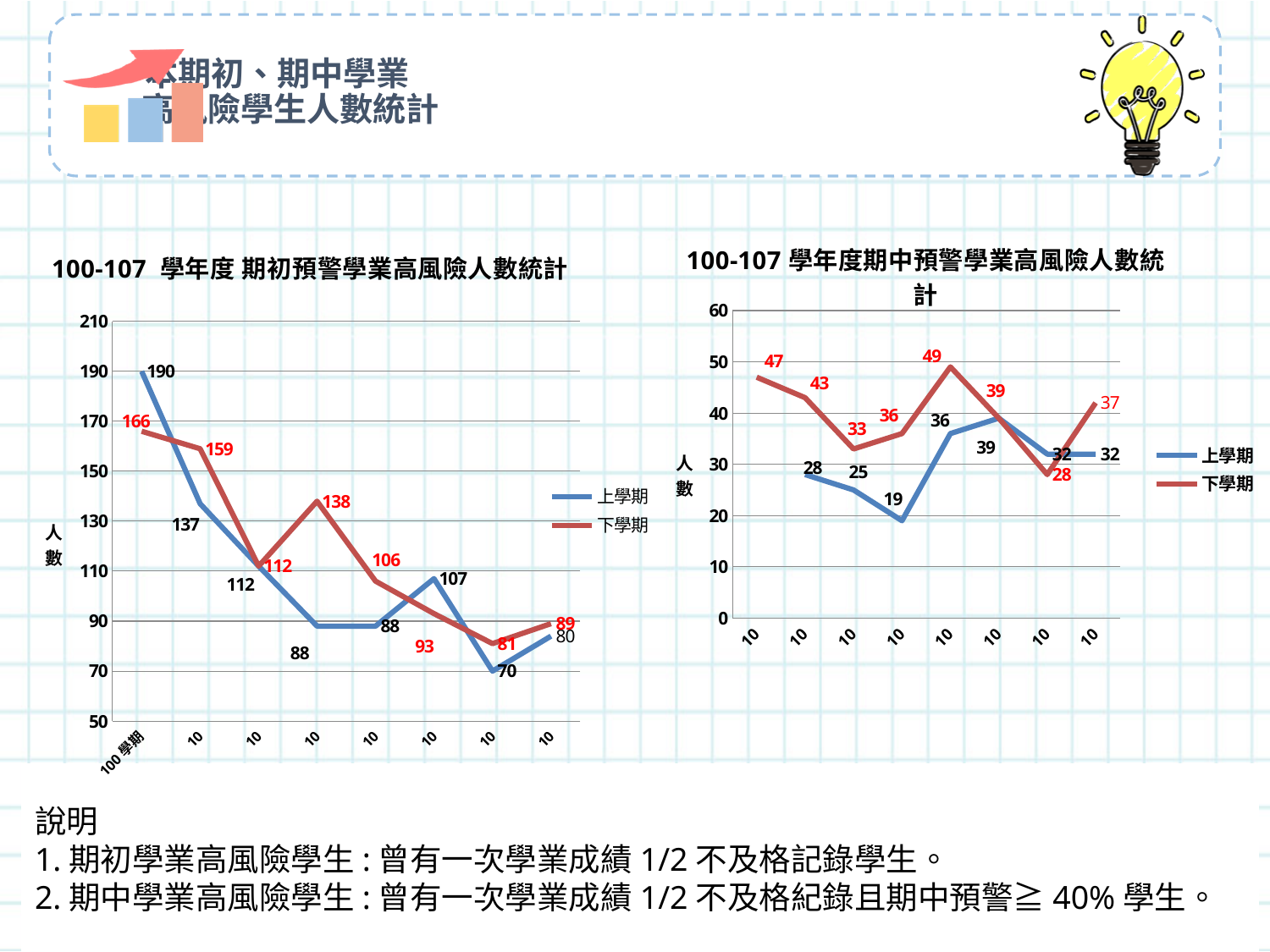
What kind of chart is the left chart titled 100-107 學年度 期初預警學業高風險人數統計? line chart In the right chart (期中預警), what is the highest value of the 下學期 series? 49 How many series does the legend of the left chart (期初預警) list? 2 In the right chart (期中預警), what is the highest value of the 上學期 series? 39 In the right chart (期中預警), what is the lowest value of the 上學期 series? 19 In the left chart (期初預警), what is the difference between 上學期 and 下學期 at 100 學期? 24 In the left chart (期初預警), what is the highest value of the 下學期 series? 166 In the left chart (期初預警), does the 上學期 series generally rise or fall from left to right? fall In the left chart (期初預警), what is the value of 上學期 for 100 學期? 190 In the left chart (期初預警), what is the lowest value of the 下學期 series? 81 In the left chart (期初預警), what is the lowest value of the 上學期 series? 70 In the right chart (期中預警), which series is shown in red? 下學期